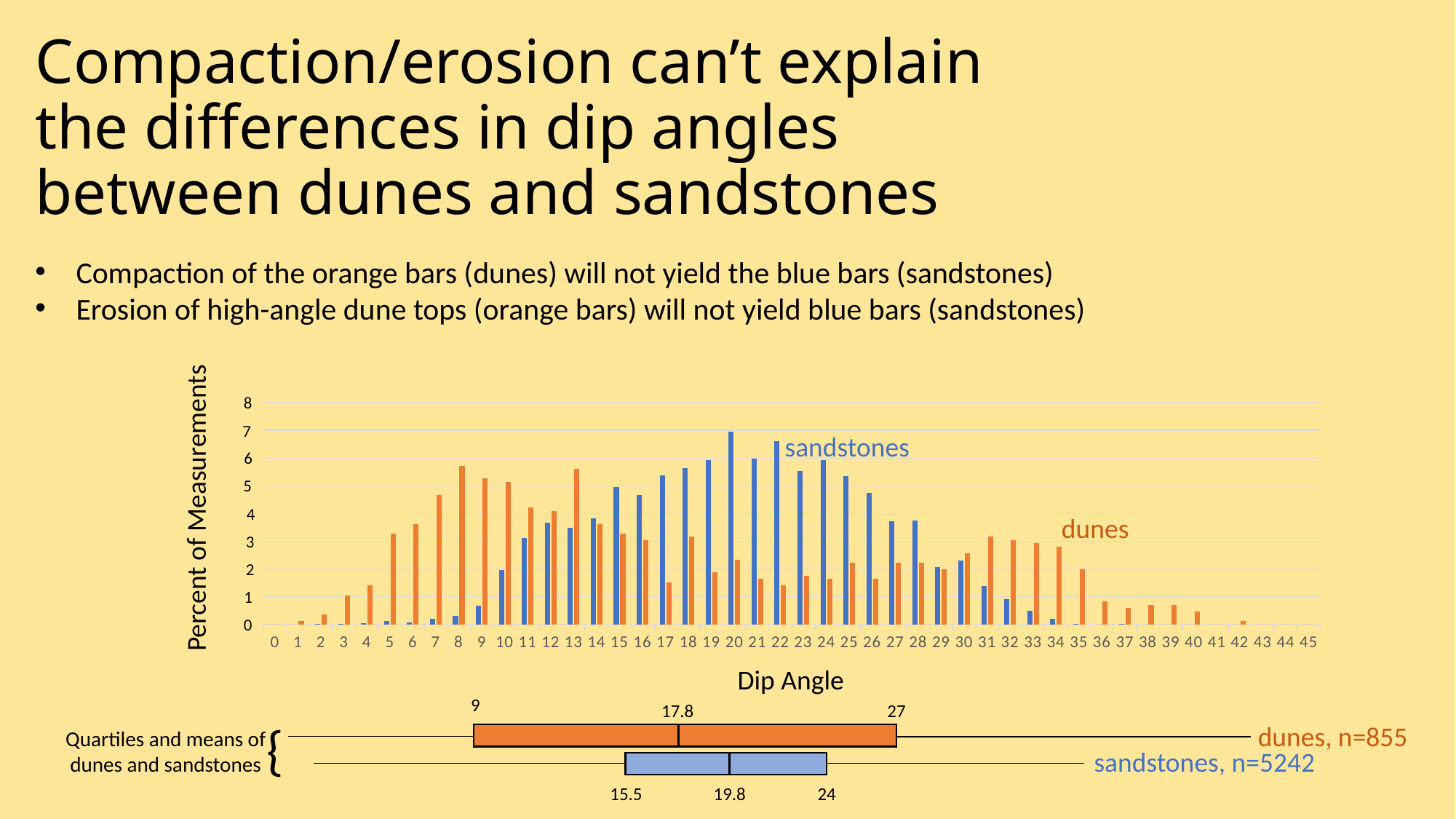
At dip angle 20, which series has the larger value, dunes or sandstones? sandstones How many data series are plotted in the bar chart? 2 Is the dunes value at dip angle 36 greater or less than 1? less Do the sandstones bars rise or fall as dip angle increases from 20 to 34? fall At dip angle 31, which series has the larger value, dunes or sandstones? dunes Is the sandstones value at dip angle 20 greater or less than 6? greater What is the sample size (n) given for sandstones? 5242 What is the mean dip angle shown for dunes in the quartile plot below the chart? 17.8 Is the sandstones value at dip angle 33 greater or less than 1? less At which dip angle is the sandstones (blue) bar highest? 20 What kind of chart is used to show the percent of measurements by dip angle? bar chart